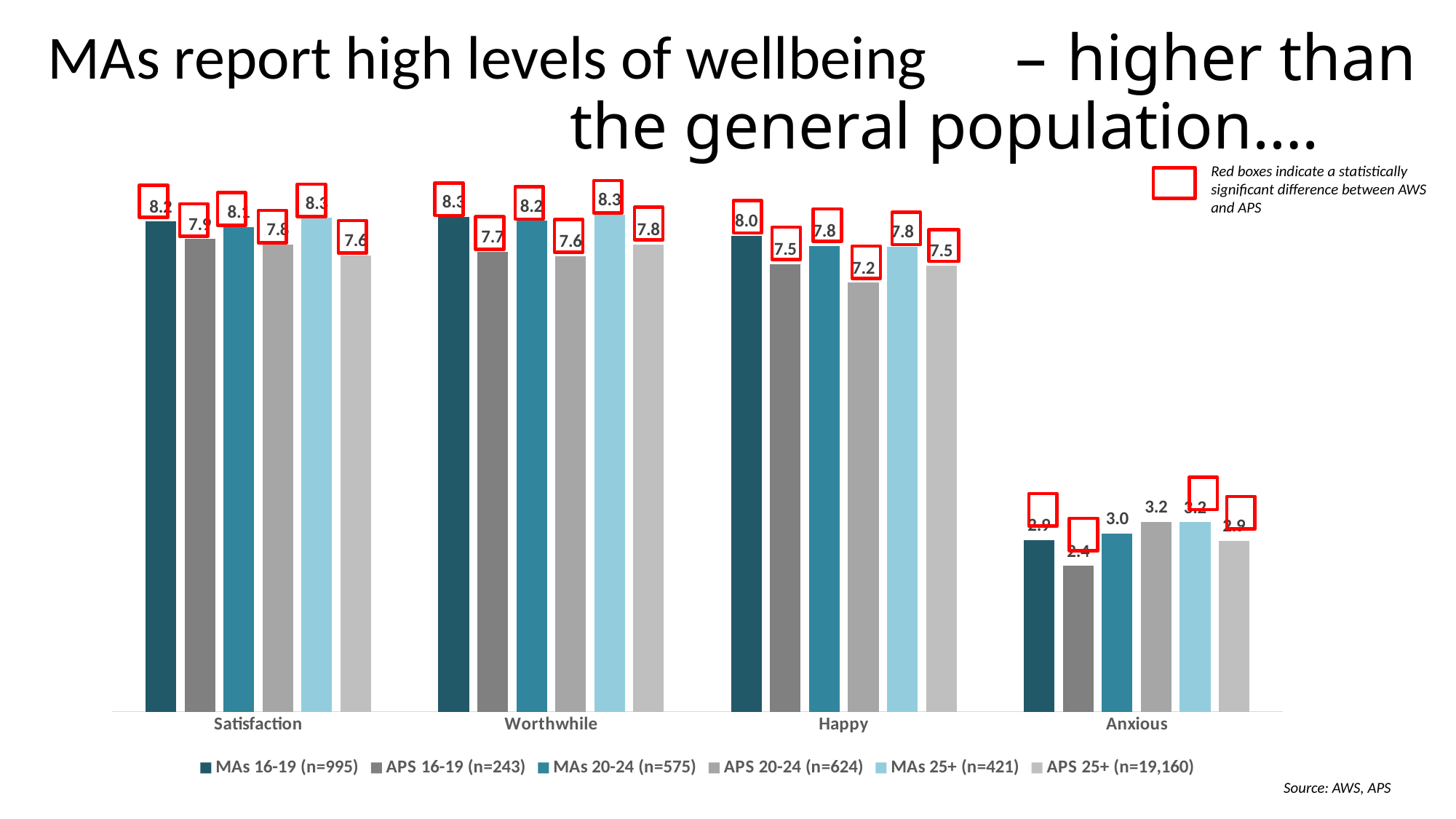
What is the difference between MAs 16-19 (n=995) and APS 16-19 (n=243) in the Happy category? 0.5 Which series has the lowest value in the Happy category? APS 20-24 (n=624) In the Worthwhile category, which is larger: MAs 16-19 (n=995) or APS 16-19 (n=243)? MAs 16-19 (n=995) What is the value for APS 20-24 (n=624) in the Worthwhile category? 7.6 What is the value for APS 20-24 (n=624) in the Happy category? 7.2 What is the value for MAs 20-24 (n=575) in the Anxious category? 3.0 How many series does the legend list? 6 What is the value for APS 20-24 (n=624) in the Anxious category? 3.2 Which series has the highest value in the Happy category? MAs 16-19 (n=995) What is the value for MAs 16-19 (n=995) in the Satisfaction category? 8.2 What kind of chart is shown on the slide? Bar chart How many categories are shown on the x axis? 4